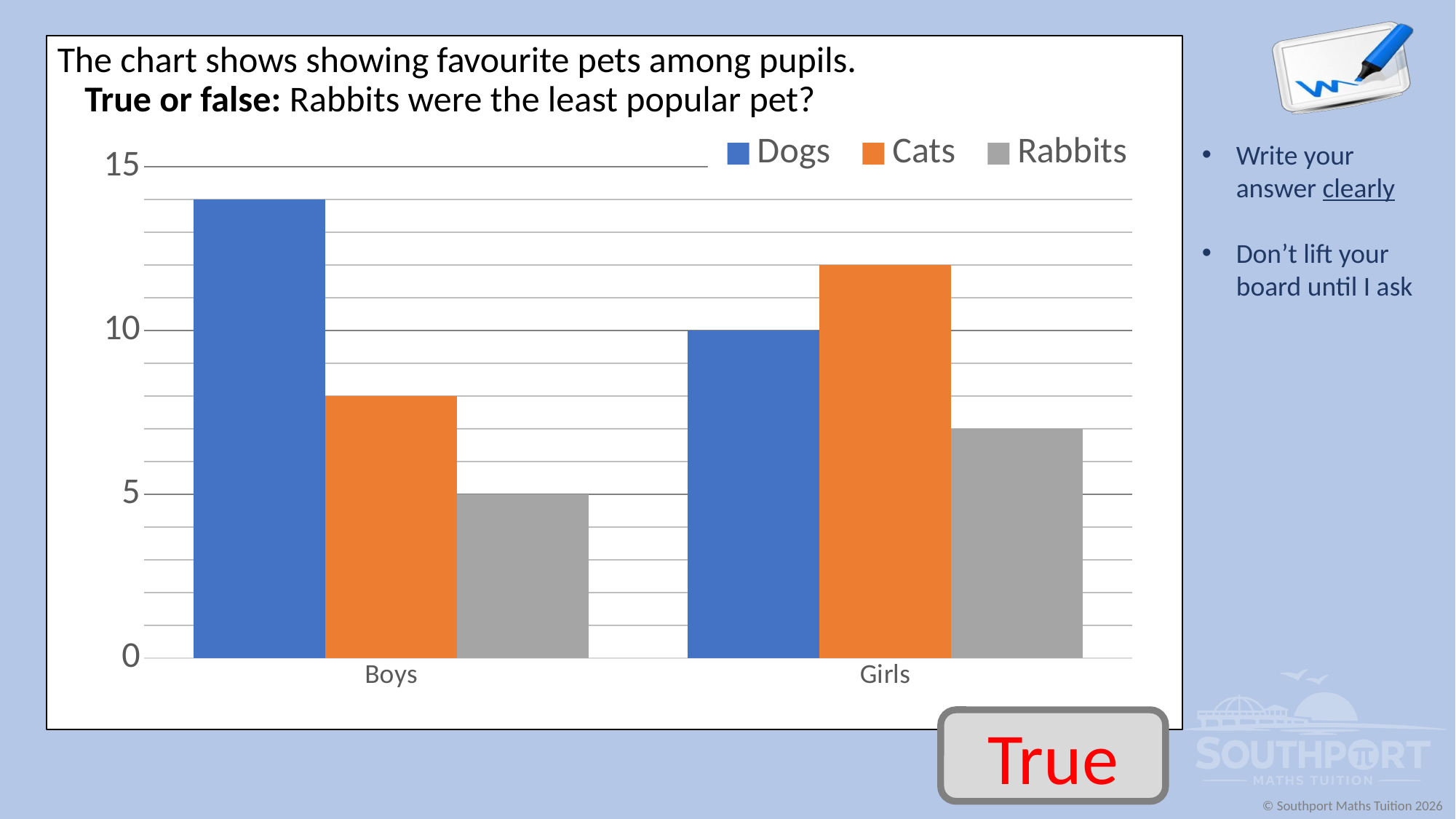
Which series is shown in orange in the legend? Cats Which pet has the lowest value among Girls? Rabbits Which pet has the highest value among Girls? Cats Which pet has the highest value among Boys? Dogs Is the value for Cats among Boys greater or less than 10? less What is the value for Rabbits among Boys? 5 How many categories are shown on the x axis? 2 How many series does the legend list? 3 Is the value for Dogs among Boys greater or less than 10? greater What is the value for Dogs among Girls? 10 Which is larger: Cats among Girls or Cats among Boys? Cats among Girls What type of chart is shown on the slide? bar chart